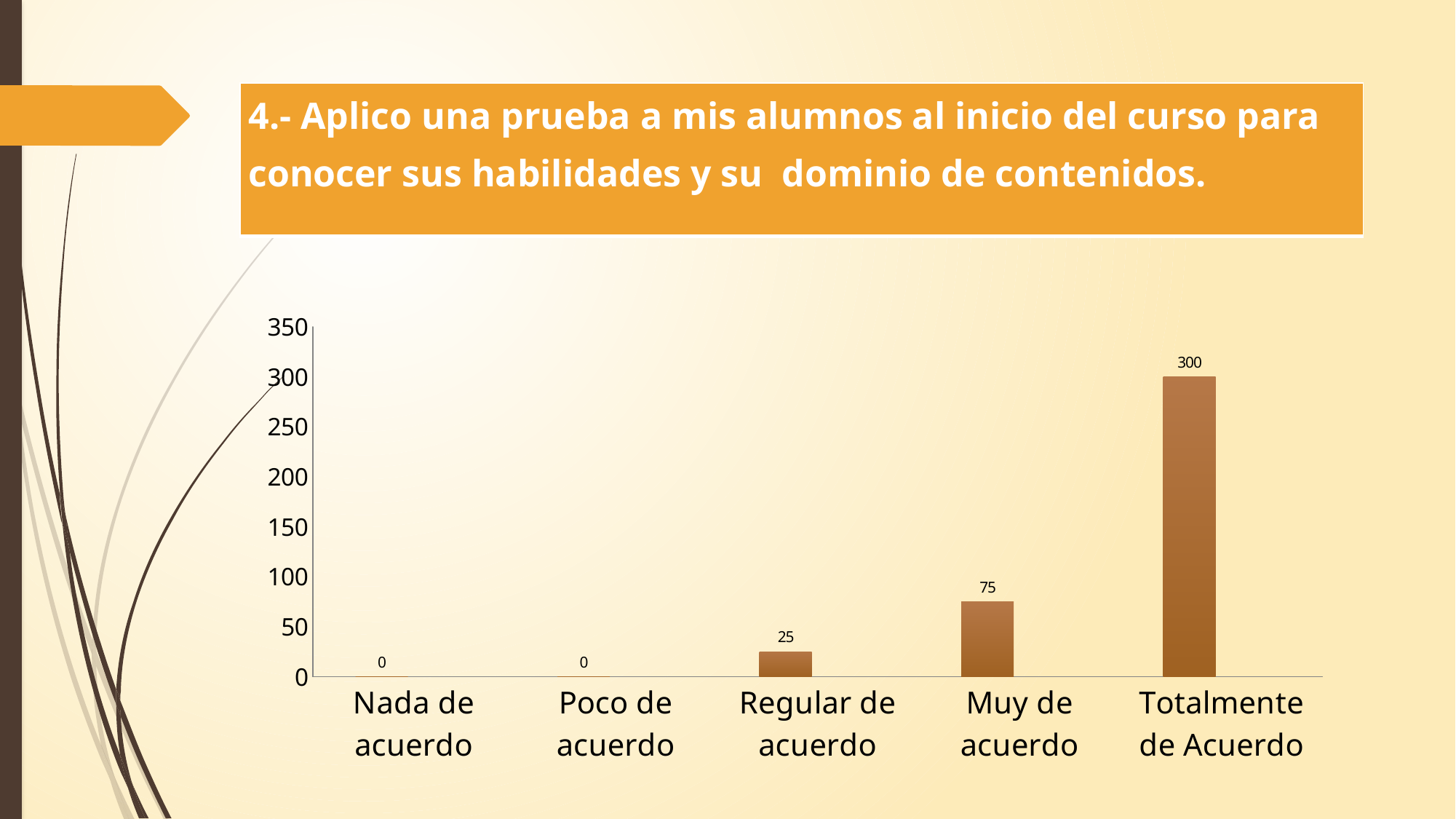
What is the value for "Nada de acuerdo"? 0 What is the difference between the values for "Muy de acuerdo" and "Regular de acuerdo"? 50 What is the value for "Totalmente de Acuerdo"? 300 Do the values rise or fall from left to right along the x axis? rise Which category has the highest value? Totalmente de Acuerdo Which is larger, the value for "Muy de acuerdo" or the value for "Regular de acuerdo"? Muy de acuerdo What kind of chart is shown on the slide? bar chart Is the value for "Totalmente de Acuerdo" greater or less than 250? greater What is the value for "Muy de acuerdo"? 75 What is the value for "Regular de acuerdo"? 25 What is the difference between the values for "Totalmente de Acuerdo" and "Muy de acuerdo"? 225 How many categories are shown on the x axis? 5